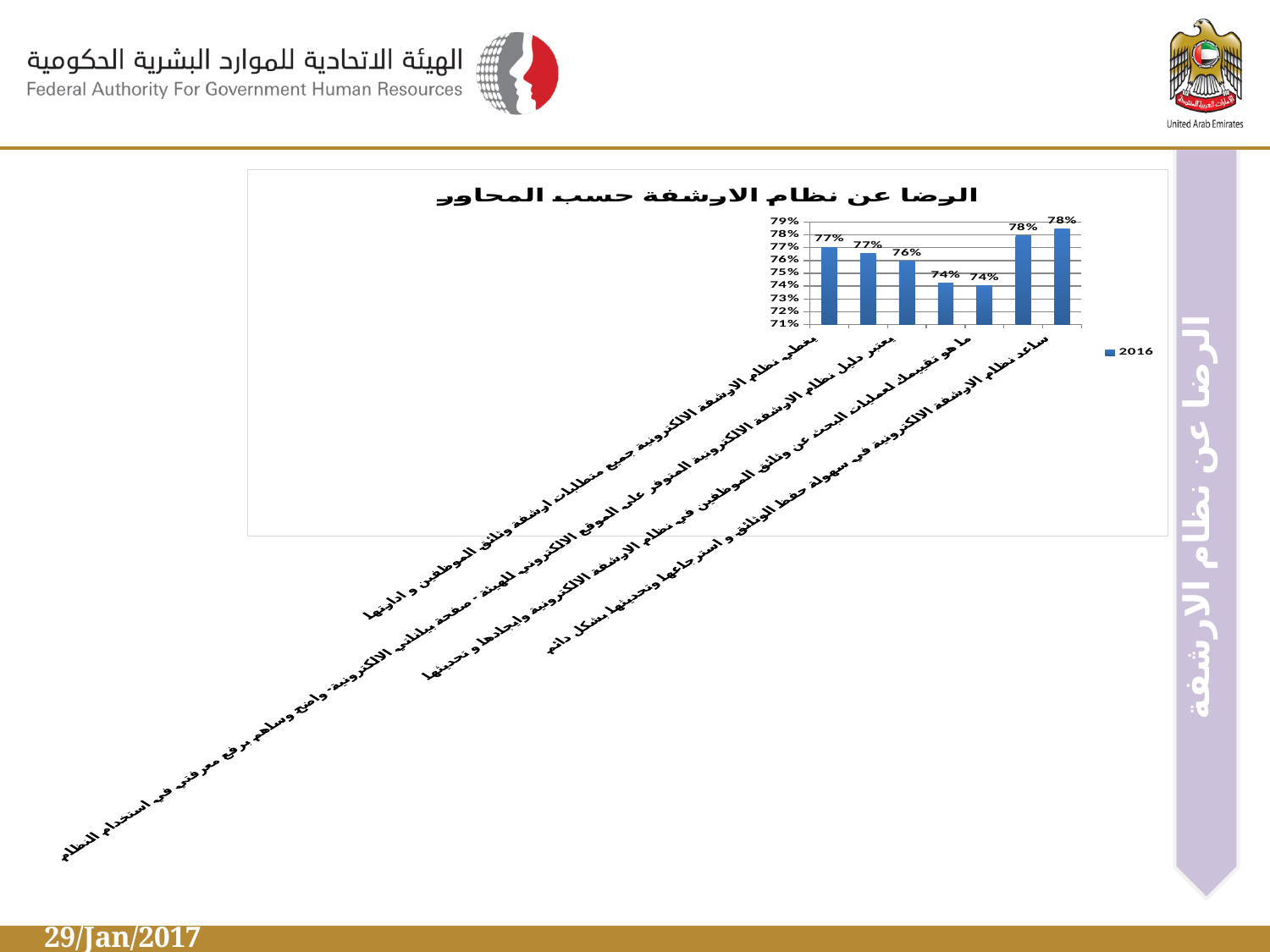
What is the value of the leftmost bar in the chart? 77% What is the lowest value shown in the chart? 74% What entry appears in the chart legend? 2016 How many series does the chart legend list? 1 What kind of chart is shown on the slide? Bar chart What is the highest value shown in the chart? 78% What is the difference between the highest and lowest values in the chart? 4 percentage points What is the value of the rightmost bar in the chart? 78% What is the title of the chart? الرضا عن نظام الارشفة حسب المحاور How many bars are plotted in the chart? 7 What is the value of the third bar from the left? 76% Which is larger, the third bar from the left or the fourth bar from the left? The third bar (76%)